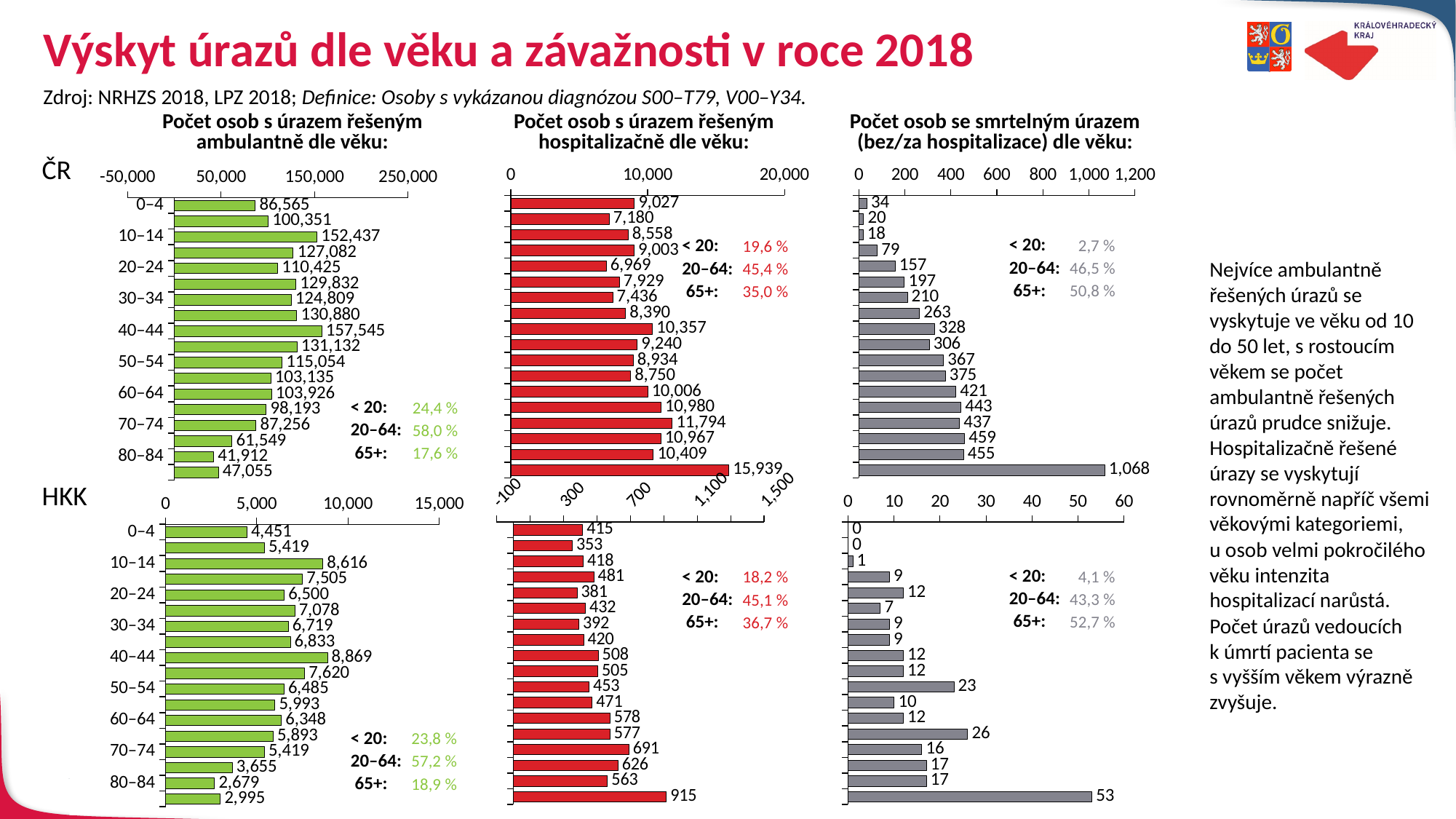
In the ČR chart 'Počet osob s úrazem řešeným hospitalizačně dle věku', which is larger: the value for 0–4 or for 40–44? 40–44 In the ČR chart 'Počet osob s úrazem řešeným ambulantně dle věku', which labelled age group has the highest value? 40–44 In the HKK chart 'Počet osob s úrazem řešeným hospitalizačně dle věku', what share is shown for the 20–64 group? 45,1 % In the HKK chart 'Počet osob se smrtelným úrazem (bez/za hospitalizace) dle věku', is the value for the 80–84 age group greater or less than 10? greater In the ČR chart 'Počet osob se smrtelným úrazem (bez/za hospitalizace) dle věku', do the values generally rise or fall with increasing age? rise In the ČR chart 'Počet osob s úrazem řešeným ambulantně dle věku', what is the difference between the 10–14 and 0–4 age groups? 65,872 In the ČR chart 'Počet osob s úrazem řešeným ambulantně dle věku', what is the value for the 10–14 age group? 152,437 What kind of chart is used for the ČR 'Počet osob s úrazem řešeným ambulantně dle věku' data? bar chart In the ČR chart 'Počet osob s úrazem řešeným hospitalizačně dle věku', what is the value for the 70–74 age group? 11,794 In the ČR chart 'Počet osob s úrazem řešeným ambulantně dle věku', what share is shown for the 65+ group? 17,6 % In the HKK chart 'Počet osob s úrazem řešeným ambulantně dle věku', which labelled age group has the lowest value? 80–84 In the HKK chart 'Počet osob se smrtelným úrazem (bez/za hospitalizace) dle věku', what is the value for the 50–54 age group? 23